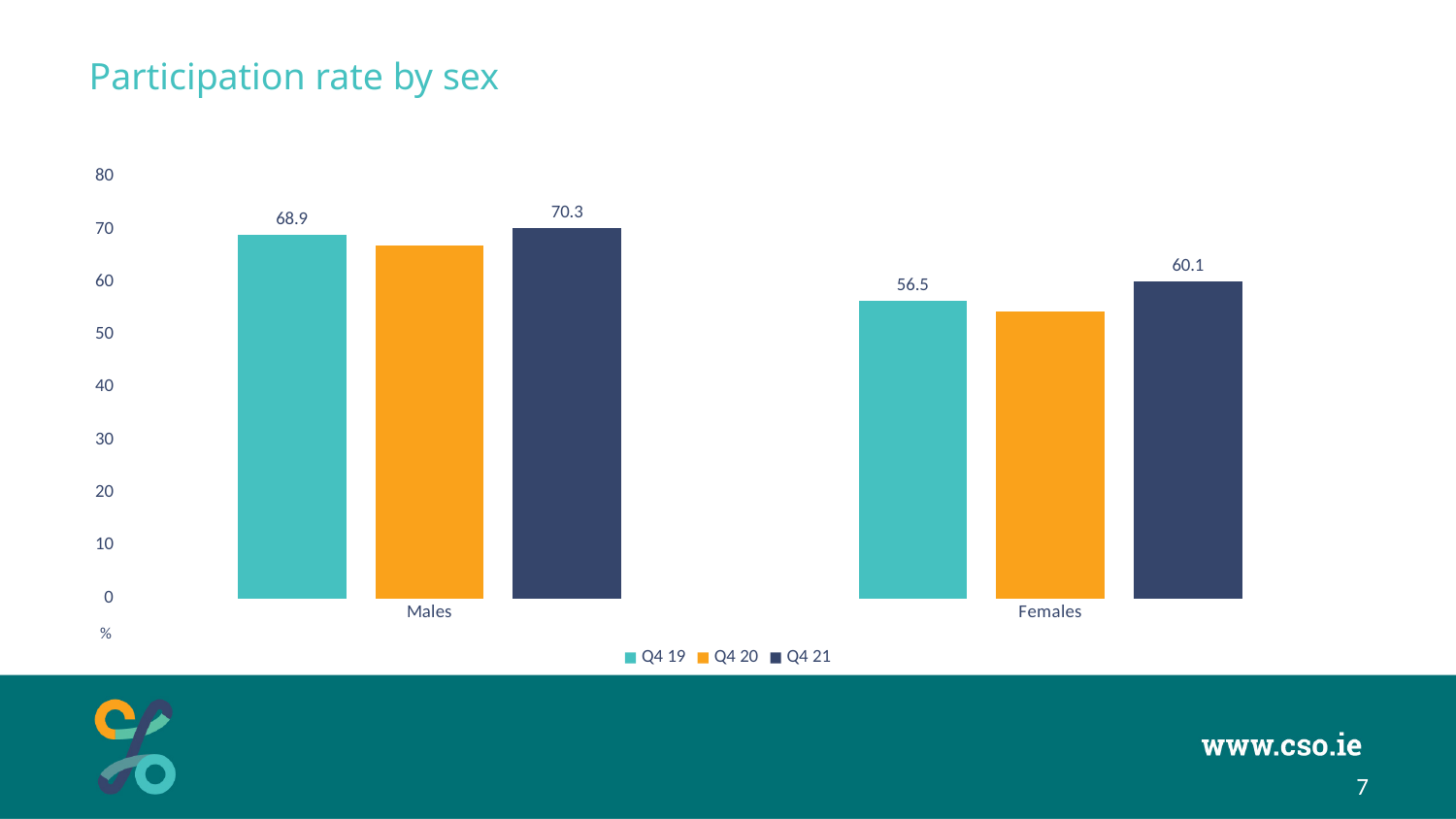
What is the participation rate for Females in Q4 21? 60.1 Is the Q4 20 participation rate for Females greater or less than 60? less Is the Q4 20 participation rate for Males greater or less than 60? greater How many series does the legend list? 3 What is the difference between the Males and Females participation rates in Q4 21? 10.2 What kind of chart is shown on the slide? bar chart What is the participation rate for Females in Q4 19? 56.5 What is the participation rate for Males in Q4 21? 70.3 By how much did the Males participation rate change from Q4 19 to Q4 21? 1.4 What is the participation rate for Males in Q4 19? 68.9 By how much did the Females participation rate change from Q4 19 to Q4 21? 3.6 In Q4 19, which group had the higher participation rate, Males or Females? Males